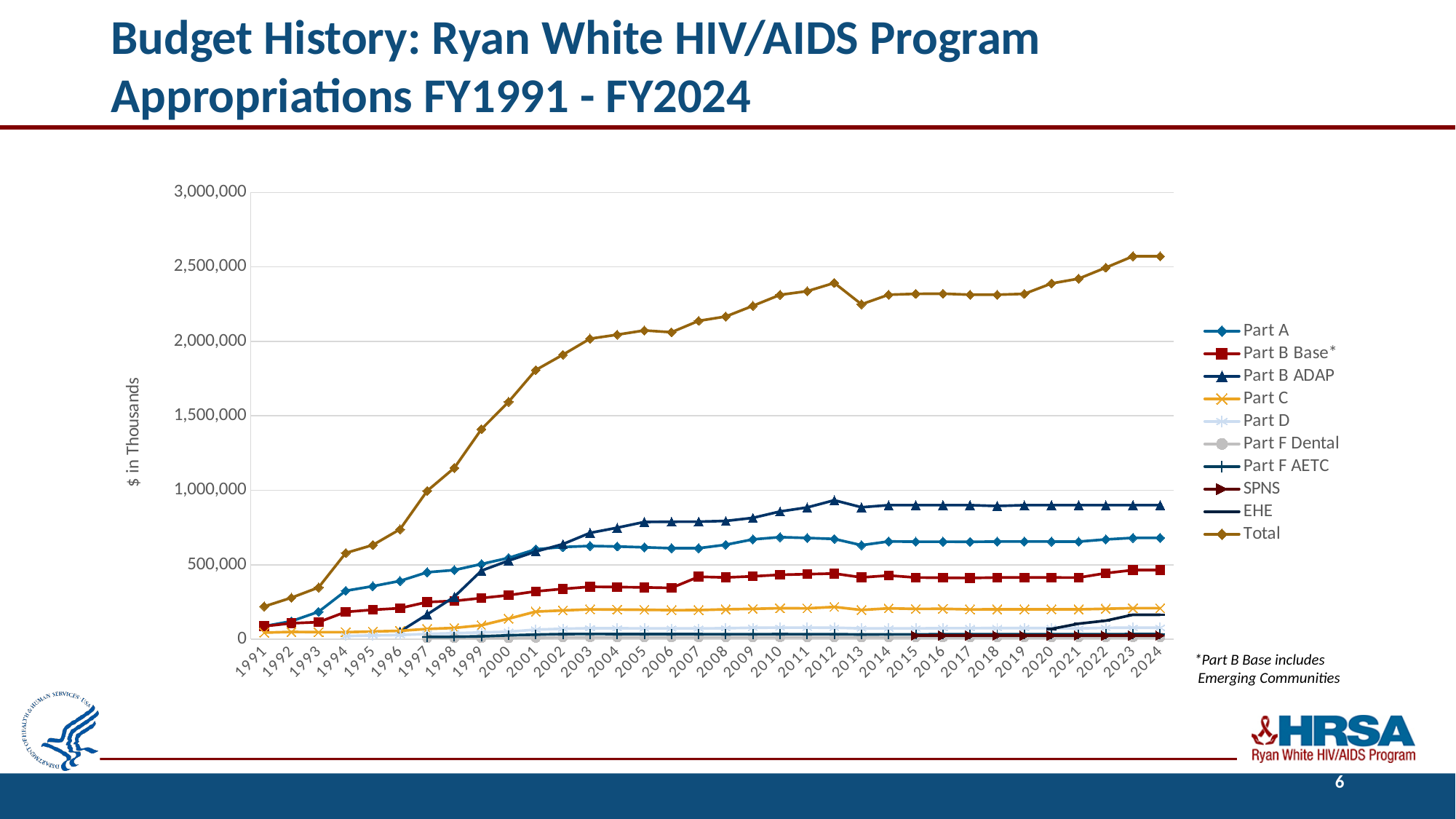
Does the Total series generally rise or fall from 1991 to 2024? Rise How many fiscal years are plotted along the x axis? 34 Is the value for Total in 2001 greater or less than 1,500,000? greater Is the value for Total in 1991 greater or less than 500,000? less What is the label on the y axis? $ in Thousands What kind of chart is shown on the slide? Line chart Is the value for Part B ADAP in 2012 greater or less than 1,000,000? less Excluding Total, which series has the highest value in 2024? Part B ADAP In 2024, which is larger: Part A or Part B Base*? Part A How many series does the legend list? 10